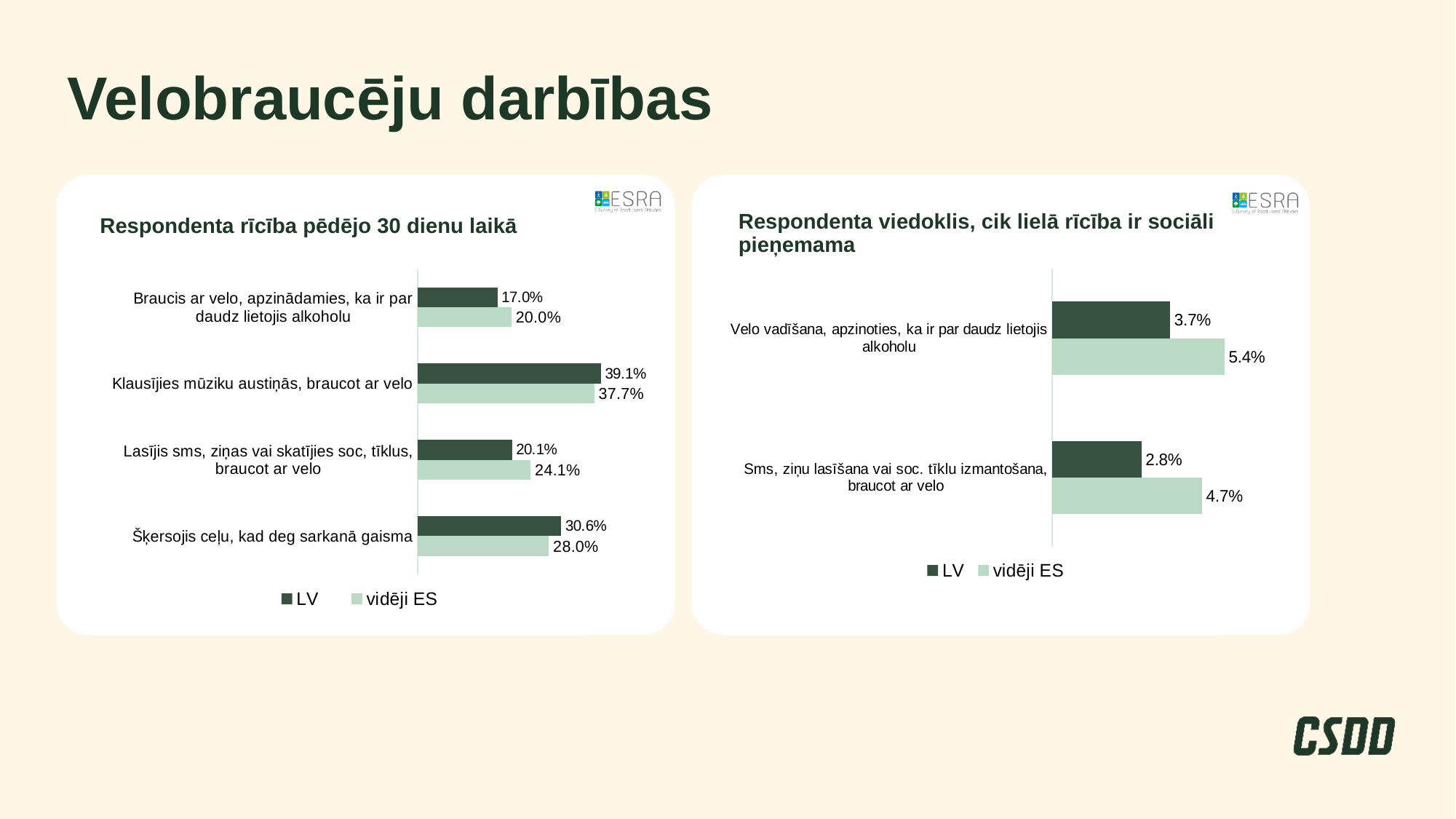
In the left chart 'Respondenta rīcība pēdējo 30 dienu laikā', what is the 'vidēji ES' value for 'Šķersojis ceļu, kad deg sarkanā gaisma'? 28.0% How many categories are shown in the left chart 'Respondenta rīcība pēdējo 30 dienu laikā'? 4 In the right chart 'Respondenta viedoklis, cik lielā rīcība ir sociāli pieņemama', what is the 'vidēji ES' value for 'Velo vadīšana, apzinoties, ka ir par daudz lietojis alkoholu'? 5.4% In the left chart 'Respondenta rīcība pēdējo 30 dienu laikā', is the LV value or the 'vidēji ES' value larger for 'Šķersojis ceļu, kad deg sarkanā gaisma'? LV What type of chart is the left chart 'Respondenta rīcība pēdējo 30 dienu laikā'? Bar chart In the left chart 'Respondenta rīcība pēdējo 30 dienu laikā', which category has the highest 'vidēji ES' value? Klausījies mūziku austiņās, braucot ar velo In the left chart 'Respondenta rīcība pēdējo 30 dienu laikā', which category has the lowest LV value? Braucis ar velo, apzinādamies, ka ir par daudz lietojis alkoholu In the left chart 'Respondenta rīcība pēdējo 30 dienu laikā', what is the LV value for 'Klausījies mūziku austiņās, braucot ar velo'? 39.1% In the left chart 'Respondenta rīcība pēdējo 30 dienu laikā', what is the difference between the 'vidēji ES' and LV values for 'Lasījis sms, ziņas vai skatījies soc, tīklus, braucot ar velo'? 4.0% In the right chart 'Respondenta viedoklis, cik lielā rīcība ir sociāli pieņemama', what is the difference between the 'vidēji ES' and LV values for 'Velo vadīšana, apzinoties, ka ir par daudz lietojis alkoholu'? 1.7% How many series does the legend of the right chart 'Respondenta viedoklis, cik lielā rīcība ir sociāli pieņemama' list? 2 In the right chart 'Respondenta viedoklis, cik lielā rīcība ir sociāli pieņemama', what is the LV value for 'Sms, ziņu lasīšana vai soc. tīklu izmantošana, braucot ar velo'? 2.8%